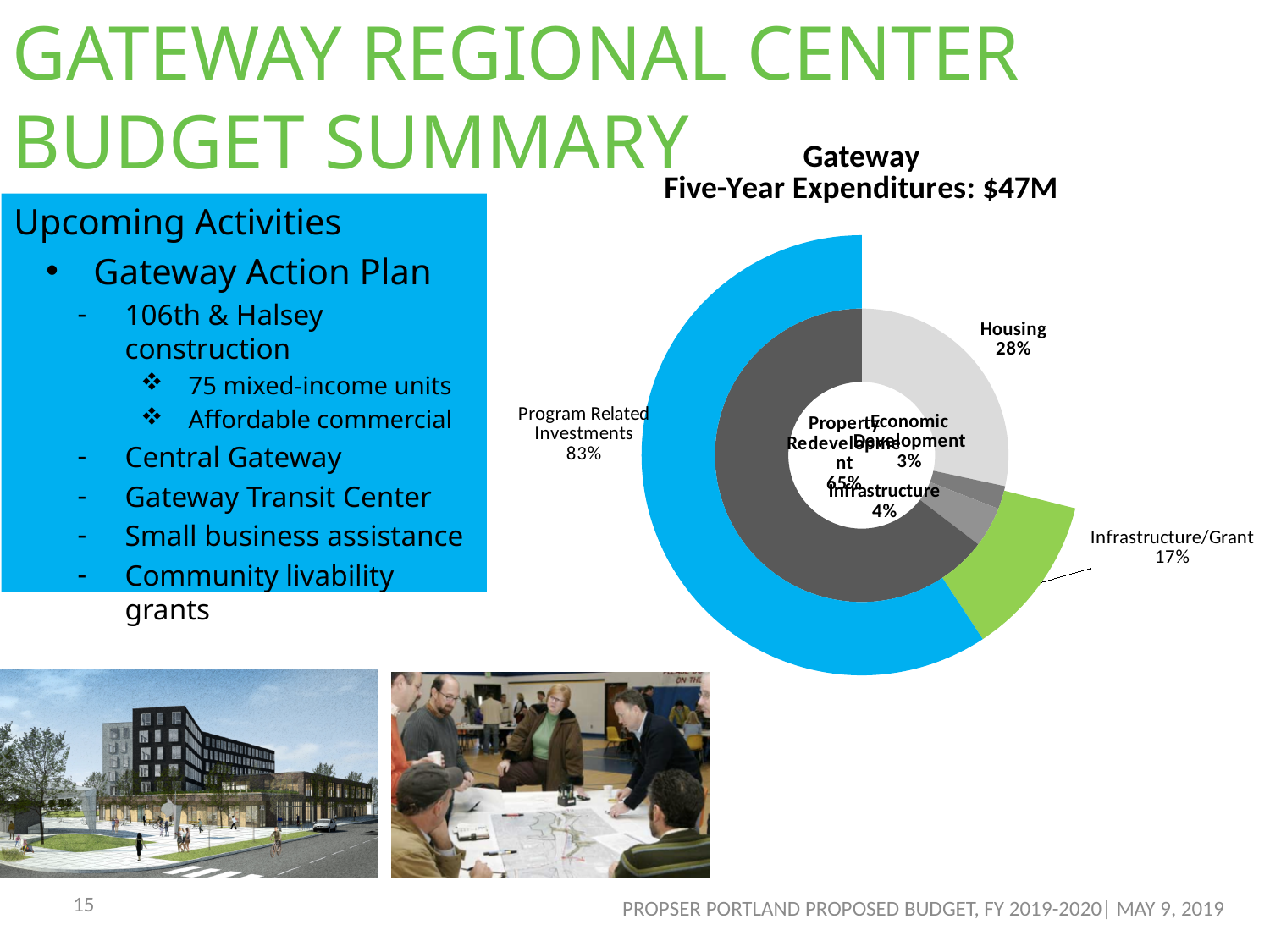
What percentage of the outer ring is Program Related Investments? 83% What percentage does Infrastructure represent in the inner ring? 4% How many categories are labelled in the outer ring of the chart? 2 What is the difference in percentage points between Program Related Investments and Infrastructure/Grant in the outer ring? 66 What kind of chart is shown on the slide? doughnut chart Which is larger in the inner ring, Housing or Infrastructure? Housing What percentage does Economic Development represent in the inner ring? 3% Which category in the inner ring has the largest share? Property Redevelopment What percentage does Housing represent in the inner ring? 28% What percentage of the outer ring is Infrastructure/Grant? 17% What is the title of the chart on the slide? Gateway Five-Year Expenditures: $47M Which category in the inner ring has the smallest share? Economic Development